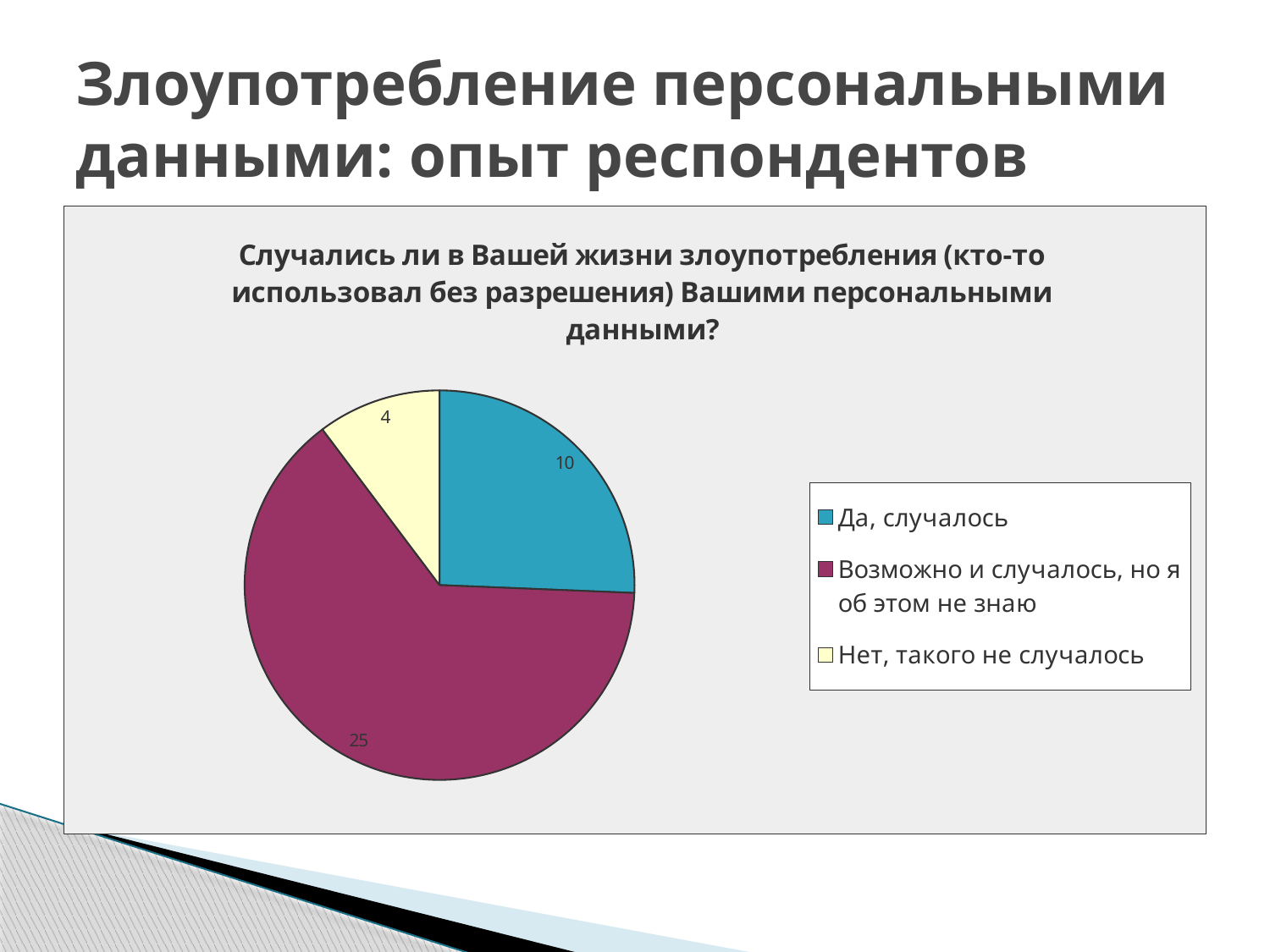
How many categories does the pie chart have? 3 What is the value for "Нет, такого не случалось"? 4 Which category has the largest slice of the pie? Возможно и случалось, но я об этом не знаю Which is larger: the value for "Да, случалось" or the value for "Нет, такого не случалось"? Да, случалось What is the difference between the values for "Да, случалось" and "Нет, такого не случалось"? 6 What is the total of all slices in the pie chart? 39 What is the value for "Да, случалось"? 10 What is the value for "Возможно и случалось, но я об этом не знаю"? 25 Which category has the smallest slice of the pie? Нет, такого не случалось What colour is the slice for "Да, случалось"? blue What is the difference between the values for "Возможно и случалось, но я об этом не знаю" and "Да, случалось"? 15 What type of chart is shown on the slide? pie chart